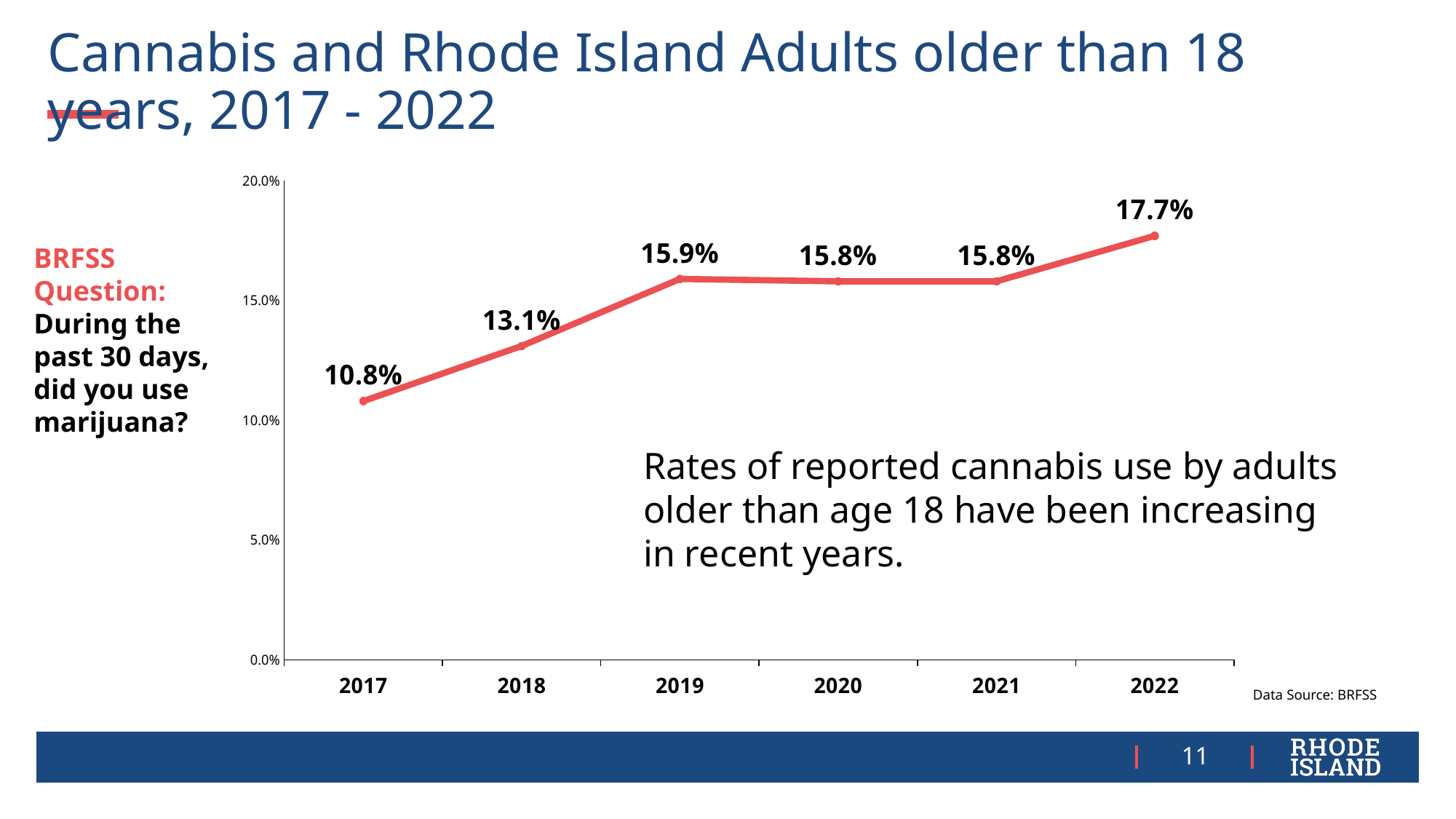
What is the difference between the values for 2022 and 2017? 6.9% Which is larger, the value for 2018 or the value for 2021? 2021 How many years are plotted on the chart? 6 What is the difference between the values for 2019 and 2018? 2.8% Do the values generally rise or fall from 2017 to 2022? rise Which year has the lowest value? 2017 What is the value for 2017? 10.8% Is the value for 2020 greater or less than 15.0%? greater What kind of chart is shown on the slide? line chart What is the value for 2022? 17.7% What is the value for 2019? 15.9% Which year has the highest value? 2022